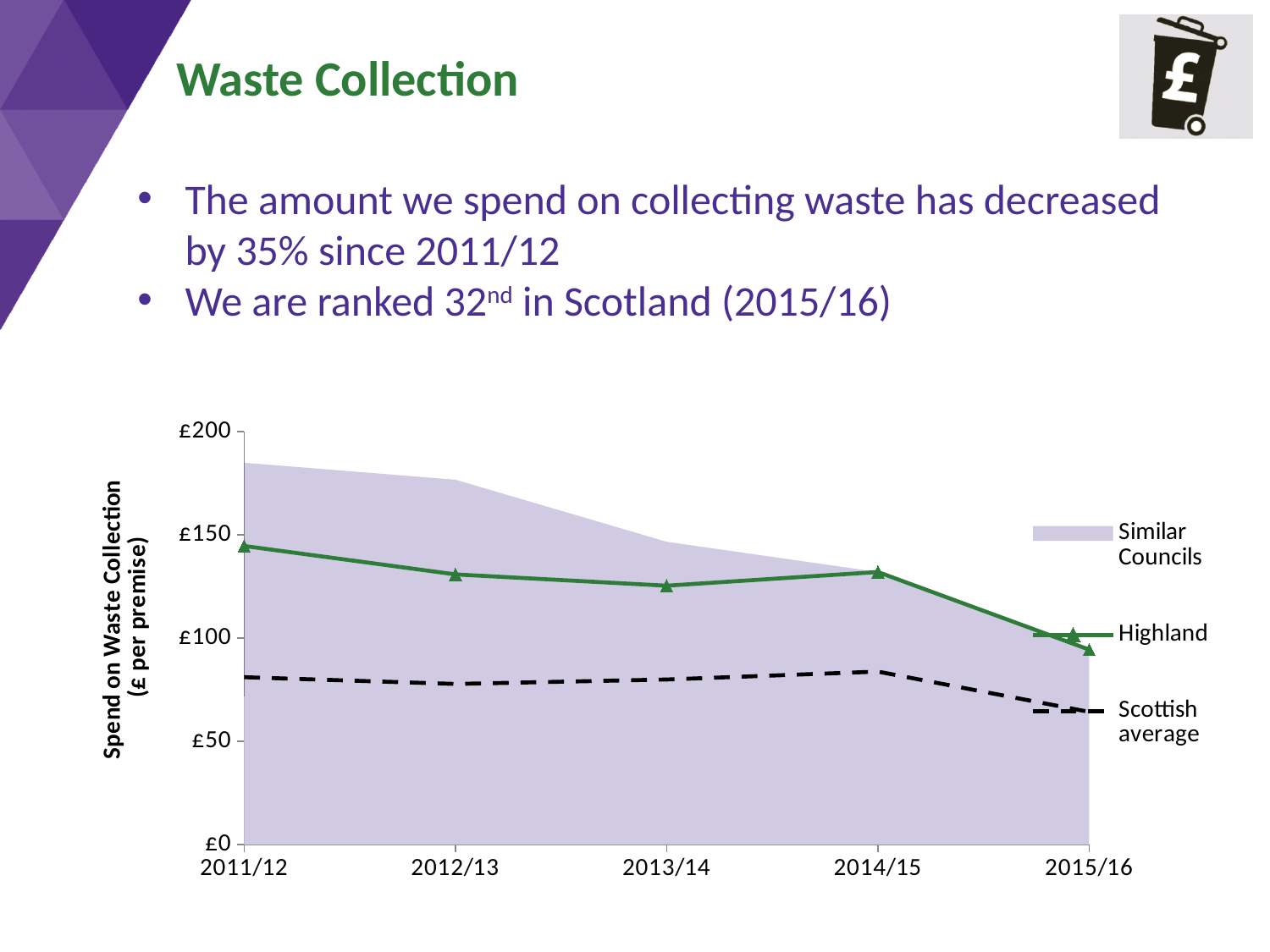
How many series does the chart's legend list? 3 In which year is the Highland spend on waste collection lowest? 2015/16 Which series is drawn as a dashed black line? Scottish average What is the label of the vertical axis? Spend on Waste Collection (£ per premise) Is the Similar Councils value for 2011/12 greater or less than £150? greater Does the Highland spend on waste collection rise or fall from 2011/12 to 2015/16? fall In 2011/12, which is larger: the Highland value or the Scottish average value? Highland In which year is the Highland spend on waste collection highest? 2011/12 Is the Highland value for 2012/13 greater or less than £100? greater Is the Scottish average value for 2014/15 greater or less than £100? less How many years are shown on the x axis of the chart? 5